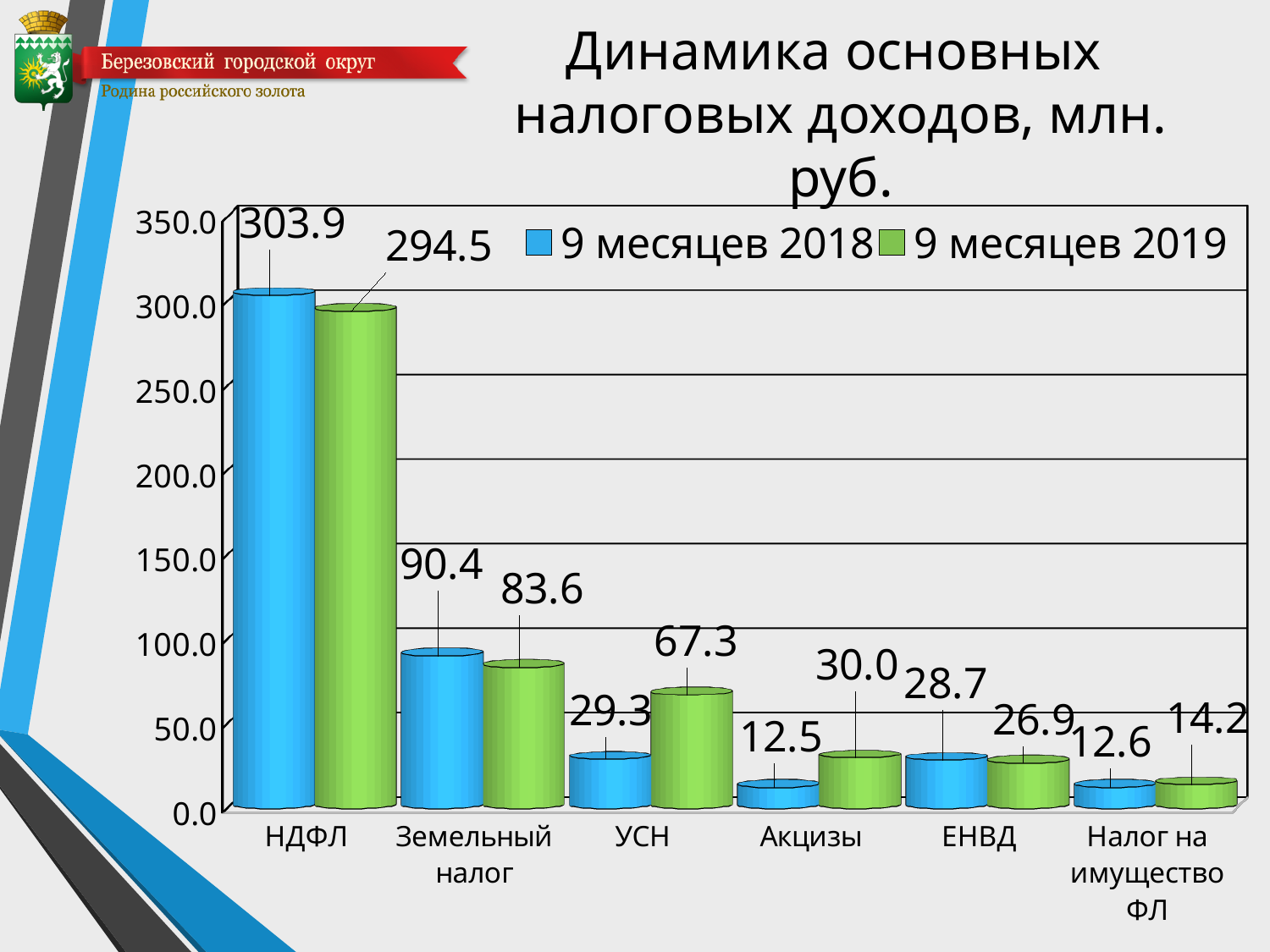
What is the value for УСН in the 9 месяцев 2019 series? 67.3 What is the value for Налог на имущество ФЛ in the 9 месяцев 2019 series? 14.2 Which category has the lowest value in the 9 месяцев 2018 series? Акцизы What is the difference between the 9 месяцев 2018 and 9 месяцев 2019 values for Земельный налог? 6.8 For УСН, which series has the larger value: 9 месяцев 2018 or 9 месяцев 2019? 9 месяцев 2019 How many series does the legend list? 2 What colour represents the 9 месяцев 2019 series? Green Which category has the highest value in the 9 месяцев 2019 series? НДФЛ What kind of chart is shown on the slide? Bar chart How many categories are shown on the x axis? 6 What is the value for НДФЛ in the 9 месяцев 2018 series? 303.9 What is the value for Акцизы in the 9 месяцев 2018 series? 12.5